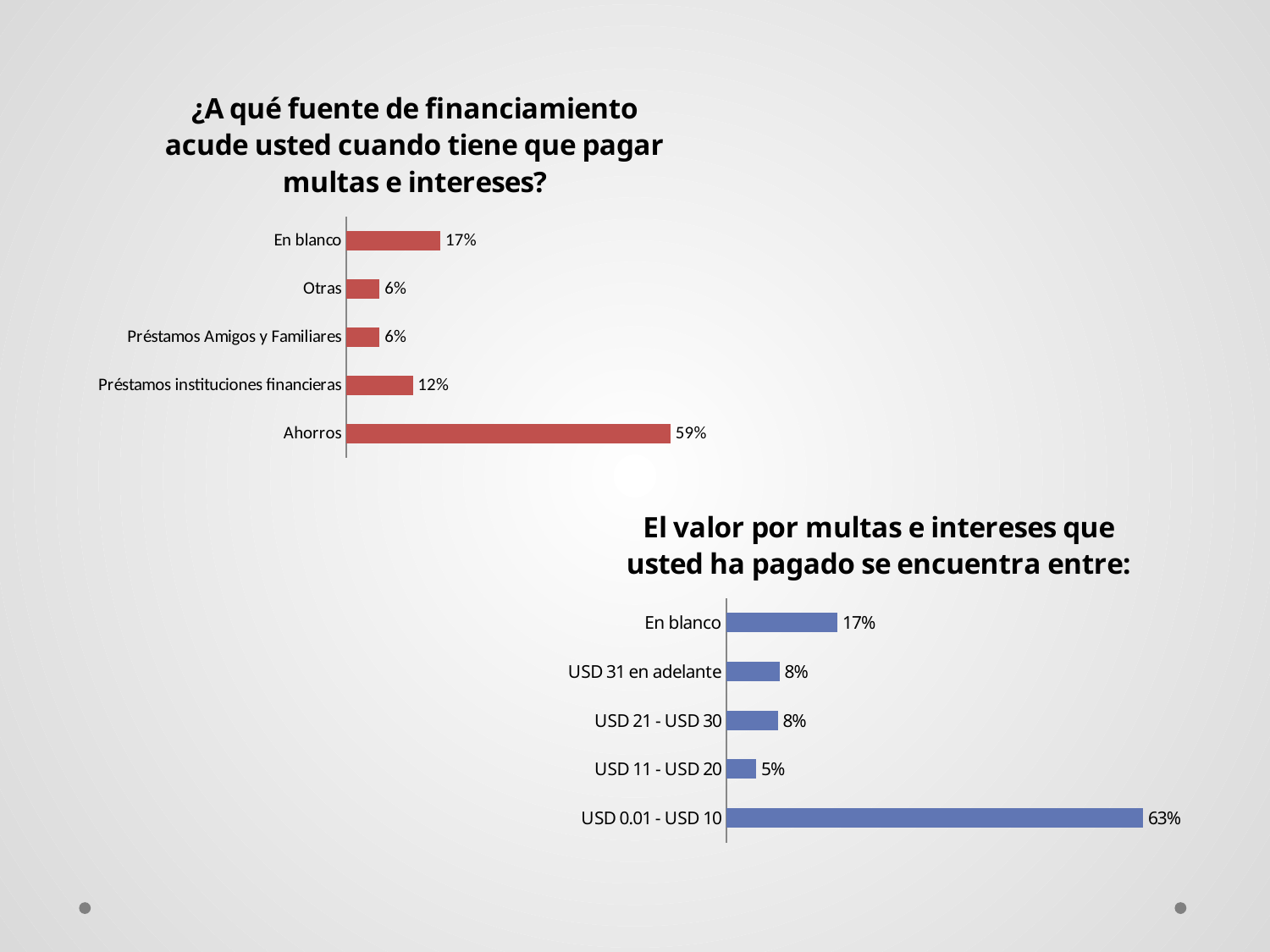
In the top-left chart '¿A qué fuente de financiamiento acude usted cuando tiene que pagar multas e intereses?', what is the value for Préstamos instituciones financieras? 12% In the top-left chart '¿A qué fuente de financiamiento acude usted cuando tiene que pagar multas e intereses?', what is the difference between Ahorros and En blanco? 42% In the bottom-right chart 'El valor por multas e intereses que usted ha pagado se encuentra entre:', what is the value for USD 0.01 - USD 10? 63% In the top-left chart '¿A qué fuente de financiamiento acude usted cuando tiene que pagar multas e intereses?', how many categories are shown? 5 What colour are the bars in the top-left chart '¿A qué fuente de financiamiento acude usted cuando tiene que pagar multas e intereses?'? Red In the top-left chart '¿A qué fuente de financiamiento acude usted cuando tiene que pagar multas e intereses?', which category has the highest value? Ahorros In the top-left chart '¿A qué fuente de financiamiento acude usted cuando tiene que pagar multas e intereses?', what is the value for Ahorros? 59% In the bottom-right chart 'El valor por multas e intereses que usted ha pagado se encuentra entre:', what is the value for USD 11 - USD 20? 5% What type of chart is the bottom-right chart 'El valor por multas e intereses que usted ha pagado se encuentra entre:'? Bar chart In the top-left chart '¿A qué fuente de financiamiento acude usted cuando tiene que pagar multas e intereses?', which is larger: En blanco or Préstamos instituciones financieras? En blanco In the bottom-right chart 'El valor por multas e intereses que usted ha pagado se encuentra entre:', what is the difference between USD 0.01 - USD 10 and En blanco? 46% In the bottom-right chart 'El valor por multas e intereses que usted ha pagado se encuentra entre:', which category has the lowest value? USD 11 - USD 20